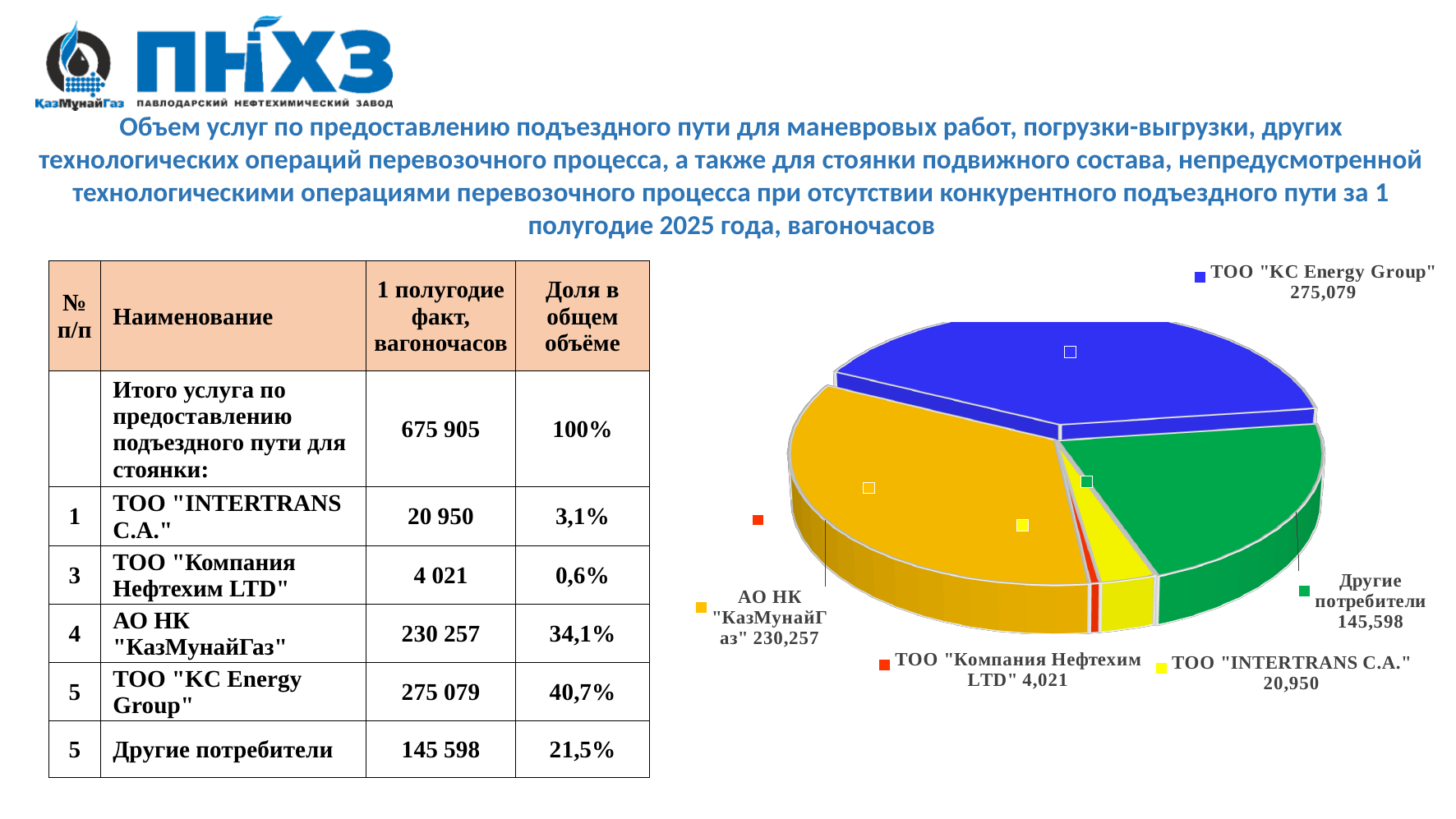
What is the value for Другие потребители in the pie chart? 145,598 What is the value for ТОО "Компания Нефтехим LTD" in the pie chart? 4,021 What is the difference between the values for ТОО "KC Energy Group" and АО НК "КазМунайГаз" in the pie chart? 44,822 What kind of chart is shown on the slide? pie chart What is the value for ТОО "INTERTRANS C.A." in the pie chart? 20,950 How many slices does the pie chart have? 5 Which is larger in the pie chart: Другие потребители or ТОО "INTERTRANS C.A."? Другие потребители What colour is the slice for АО НК "КазМунайГаз" in the pie chart? orange What is the value for ТОО "KC Energy Group" in the pie chart? 275,079 What is the value for АО НК "КазМунайГаз" in the pie chart? 230,257 Which slice of the pie chart is the smallest? ТОО "Компания Нефтехим LTD" Which slice of the pie chart is the largest? ТОО "KC Energy Group"